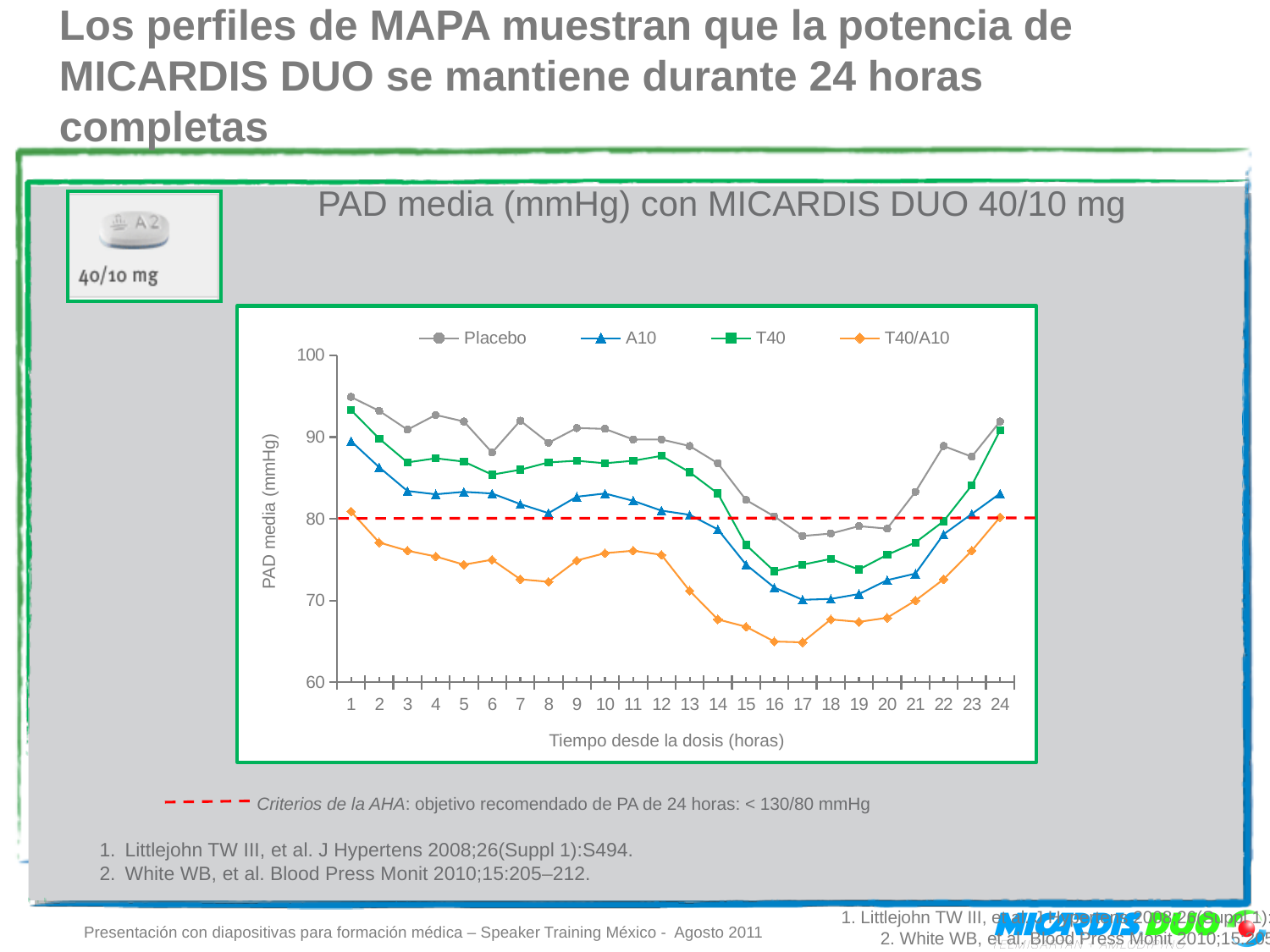
Which series has the highest value at hour 1? Placebo Is the Placebo value at hour 1 greater or less than 90? greater What kind of chart is shown on the slide? Line chart Does the Placebo line rise or fall between hour 12 and hour 17? Fall Is the T40/A10 value at hour 16 greater or less than 70? less What is the label of the y axis? PAD media (mmHg) Is the A10 value at hour 3 greater or less than 80? greater How many series does the chart legend list? 4 How many time points (hours) are shown along the x axis? 24 Which series has the lowest value at hour 17? T40/A10 At hour 12, which series has the larger value, Placebo or T40/A10? Placebo